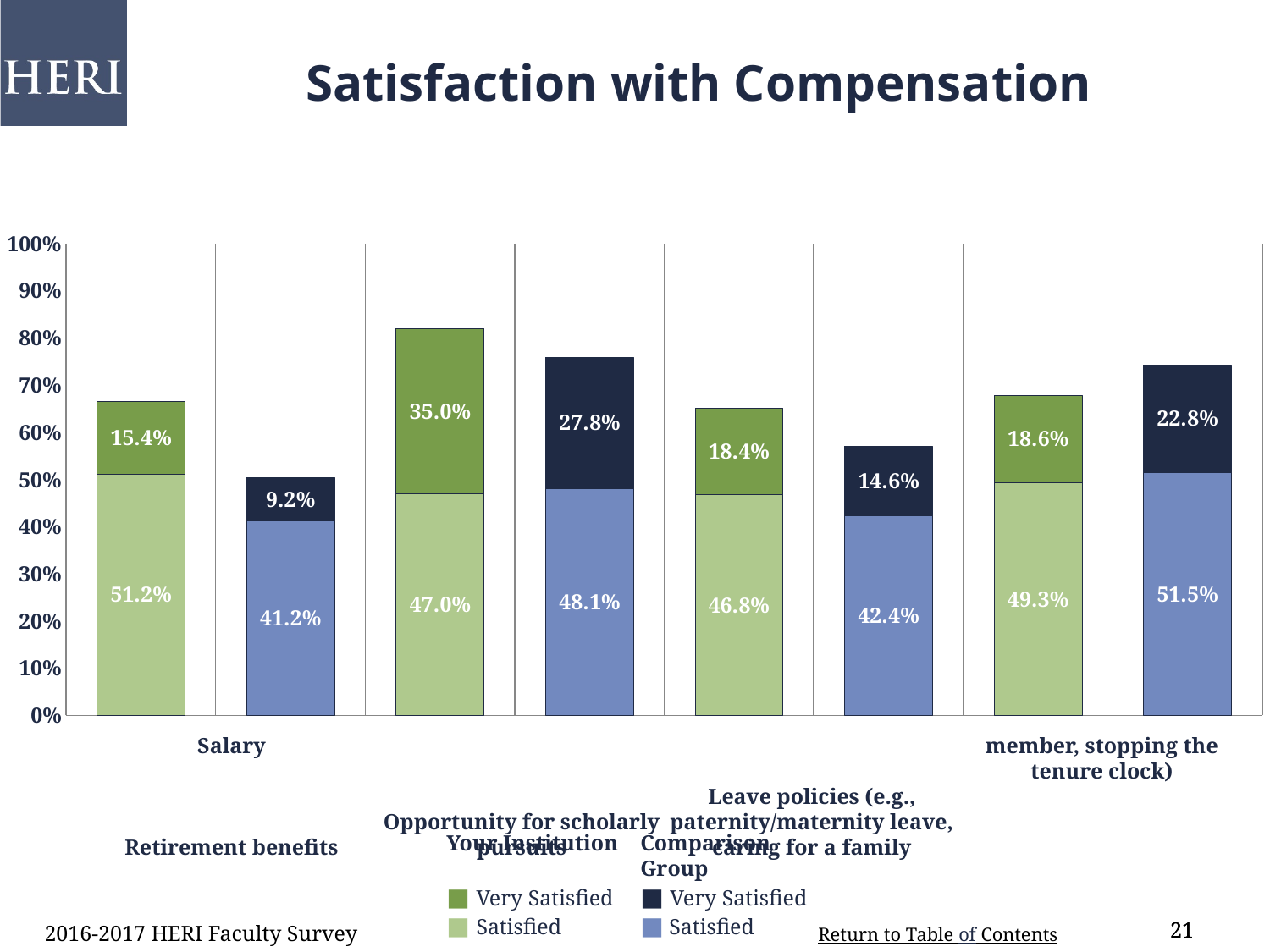
For which compensation category is the Very Satisfied percentage for Your Institution the highest? Retirement benefits What percentage of the Comparison Group is Very Satisfied with Leave policies? 22.8% What type of chart is shown on the slide? Stacked bar chart What percentage of Your Institution faculty are Very Satisfied with Salary? 15.4% For which compensation category is the Very Satisfied percentage for the Comparison Group the lowest? Salary Which group has the larger Satisfied percentage for Leave policies, Your Institution or the Comparison Group? Comparison Group What percentage of Your Institution faculty are Satisfied with Opportunity for scholarly pursuits? 46.8% What is the total percentage (Satisfied plus Very Satisfied) for the Comparison Group on Salary? 50.4% What is the total percentage (Satisfied plus Very Satisfied) for Your Institution on Retirement benefits? 82.0% How many entries does the legend list? 4 What percentage of the Comparison Group is Satisfied with Retirement benefits? 48.1% What is the difference between the Very Satisfied percentages for Your Institution and the Comparison Group on Retirement benefits? 7.2%